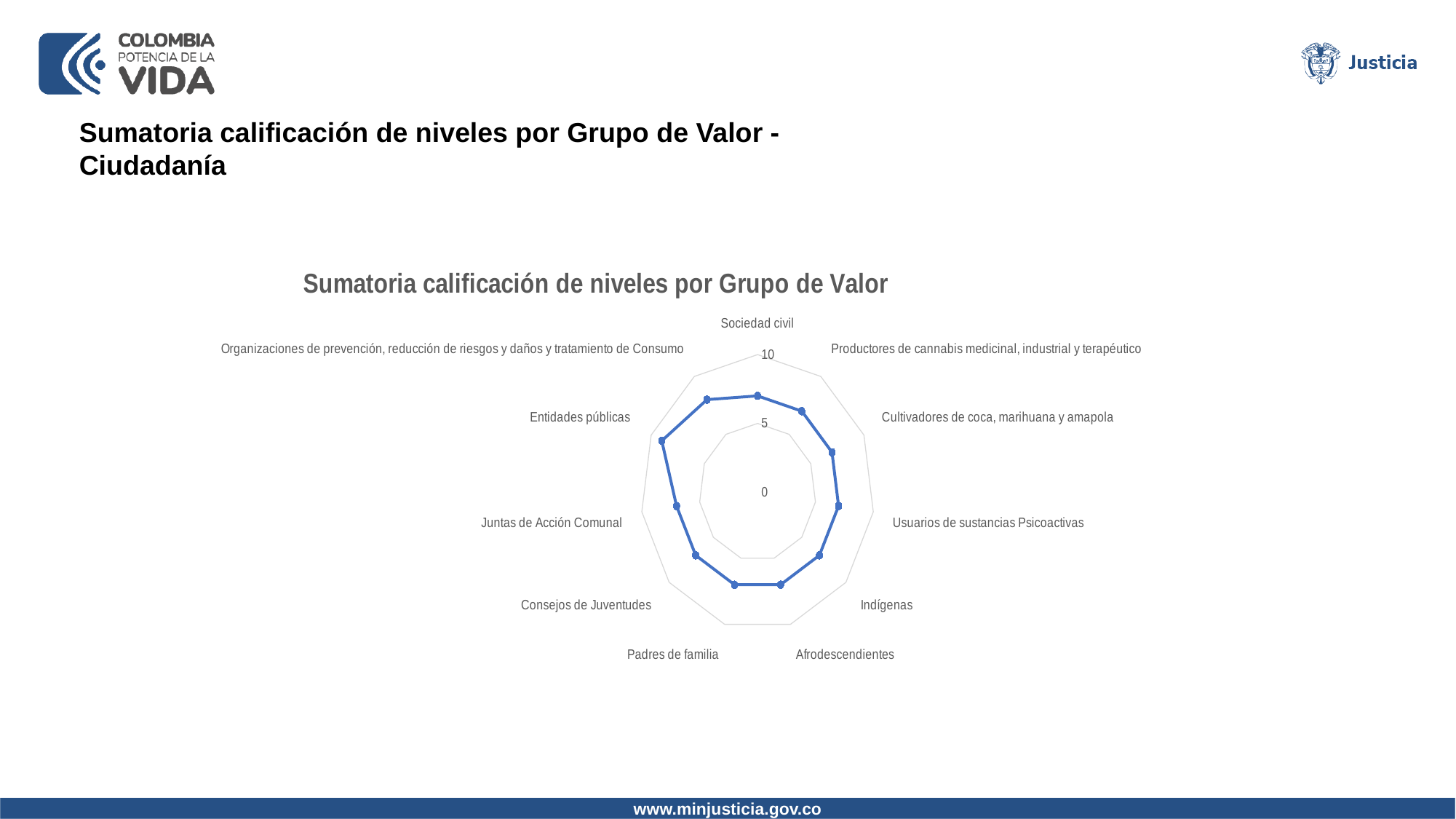
Is the value for Usuarios de sustancias Psicoactivas greater or less than 5? greater What is the title of the chart? Sumatoria calificación de niveles por Grupo de Valor Is the value for Padres de familia greater or less than 5? greater Is the value for Cultivadores de coca, marihuana y amapola greater or less than 10? less What kind of chart is shown on the slide? radar chart How many categories (groups) are plotted on the radar chart? 11 What is the maximum value shown on the radar chart's axis scale? 10